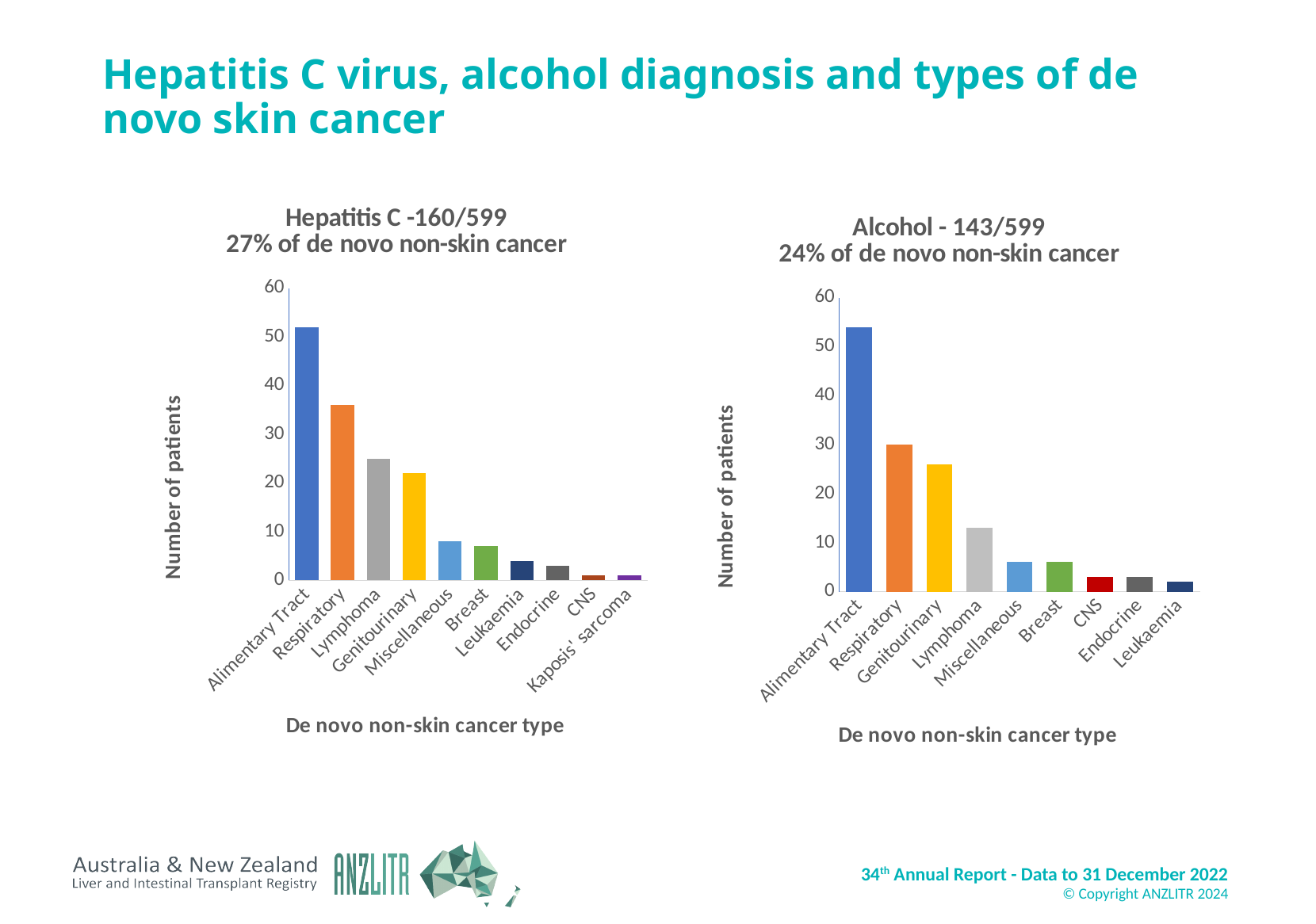
On the Hepatitis C chart, which has more patients, Respiratory or Lymphoma? Respiratory On the Alcohol chart, how many cancer type categories are shown on the x axis? 9 On the Hepatitis C chart, is the value for Alimentary Tract greater or less than 50? greater On the Hepatitis C chart, is the value for Miscellaneous greater or less than 10? less On the Alcohol chart, is the value for Lymphoma greater or less than 10? greater On the Alcohol chart, do the values rise or fall moving from left to right along the x axis? fall On the Alcohol chart, which de novo non-skin cancer type has the highest number of patients? Alimentary Tract What kind of chart is the Alcohol chart on the right? bar chart On the Hepatitis C chart, how many cancer type categories are shown on the x axis? 10 On the Hepatitis C chart, which de novo non-skin cancer type has the highest number of patients? Alimentary Tract